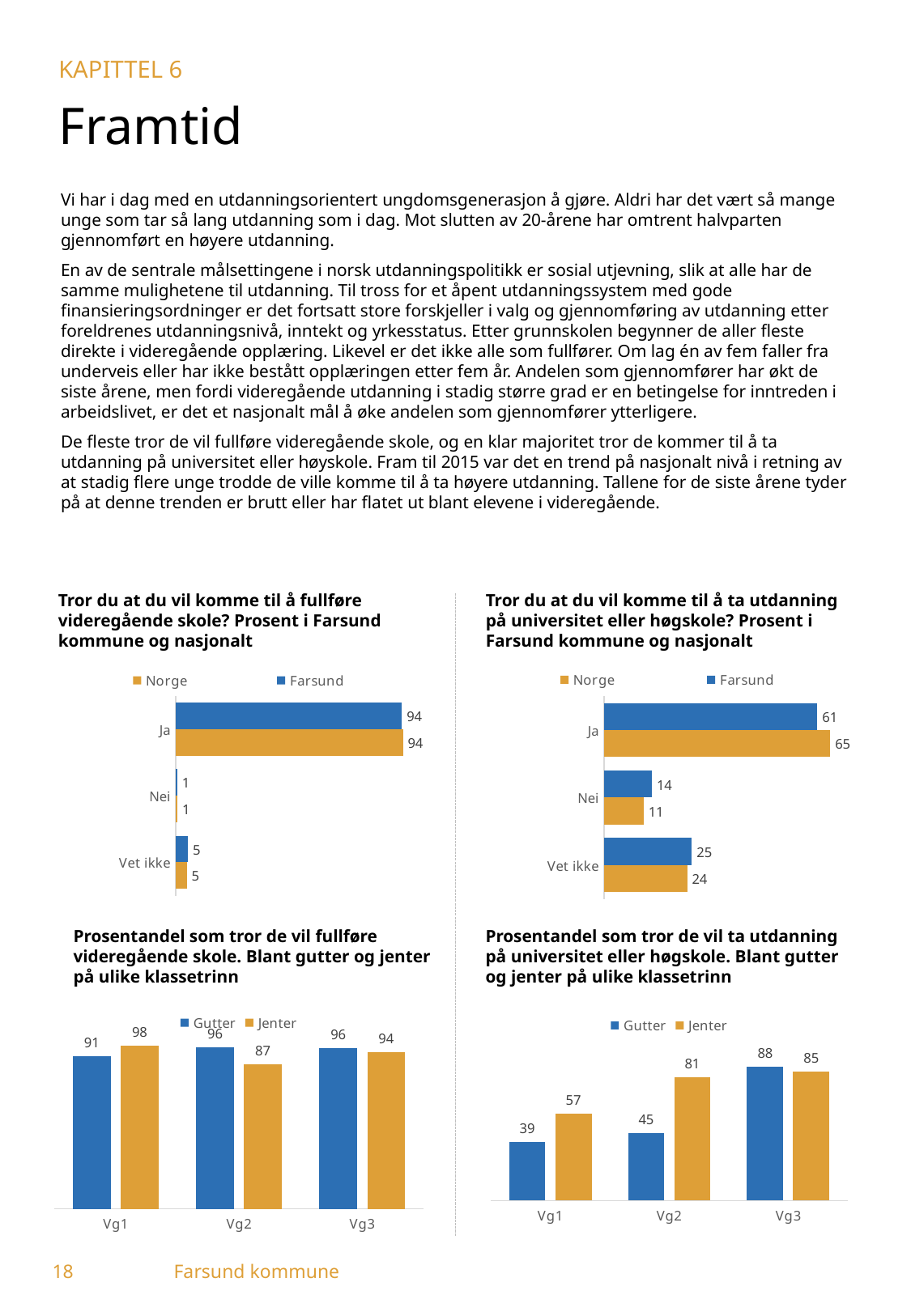
In the top-right chart ("Tror du at du vil komme til å ta utdanning på universitet eller høgskole?"), what is the value for Norge for "Nei"? 11 In the bottom-right chart ("Prosentandel som tror de vil ta utdanning på universitet eller høgskole"), do the Gutter values rise or fall from Vg1 to Vg3? rise In the top-left chart ("Tror du at du vil komme til å fullføre videregående skole?"), what is the value for Farsund for "Vet ikke"? 5 In the top-right chart ("Tror du at du vil komme til å ta utdanning på universitet eller høgskole?"), what is the difference between Norge and Farsund for "Ja"? 4 In the top-left chart ("Tror du at du vil komme til å fullføre videregående skole?"), which category has the highest value for Farsund? Ja In the bottom-right chart ("Prosentandel som tror de vil ta utdanning på universitet eller høgskole"), what is the value for Gutter at Vg1? 39 In the top-right chart ("Tror du at du vil komme til å ta utdanning på universitet eller høgskole?"), what is the value for Farsund for "Ja"? 61 In the bottom-left chart ("Prosentandel som tror de vil fullføre videregående skole"), what is the value for Jenter at Vg2? 87 In the top-left chart ("Tror du at du vil komme til å fullføre videregående skole?"), how many series does the legend list? 2 What kind of chart is the bottom-right chart ("Prosentandel som tror de vil ta utdanning på universitet eller høgskole")? bar chart In the bottom-left chart ("Prosentandel som tror de vil fullføre videregående skole"), which is larger at Vg1, Gutter or Jenter? Jenter In the bottom-right chart ("Prosentandel som tror de vil ta utdanning på universitet eller høgskole"), what is the difference between Jenter and Gutter at Vg2? 36